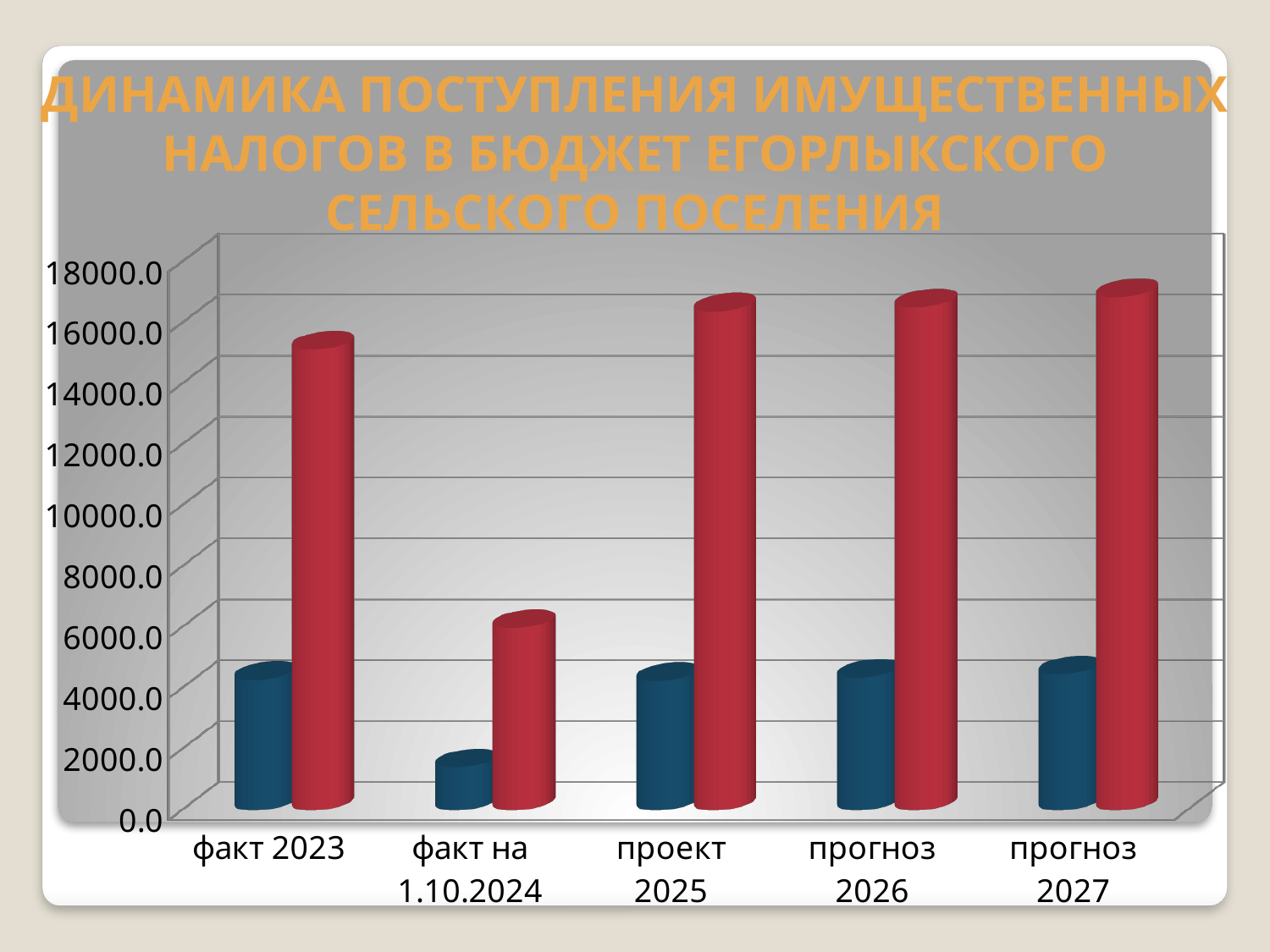
Is the red bar for факт 2023 greater or less than 14000.0? greater What kind of chart is shown on the slide? bar chart Is the red bar for прогноз 2027 greater or less than 16000.0? greater Which is larger, the red bar for факт 2023 or the red bar for проект 2025? проект 2025 Which category has the lowest red bar? факт на 1.10.2024 How many categories are shown on the x axis? 5 Is the red bar for факт на 1.10.2024 greater or less than 8000.0? less Do the red bars rise or fall from проект 2025 to прогноз 2027? rise Which category has the highest red bar? прогноз 2027 Which category has the lowest blue bar? факт на 1.10.2024 How many bars are plotted for each category? 2